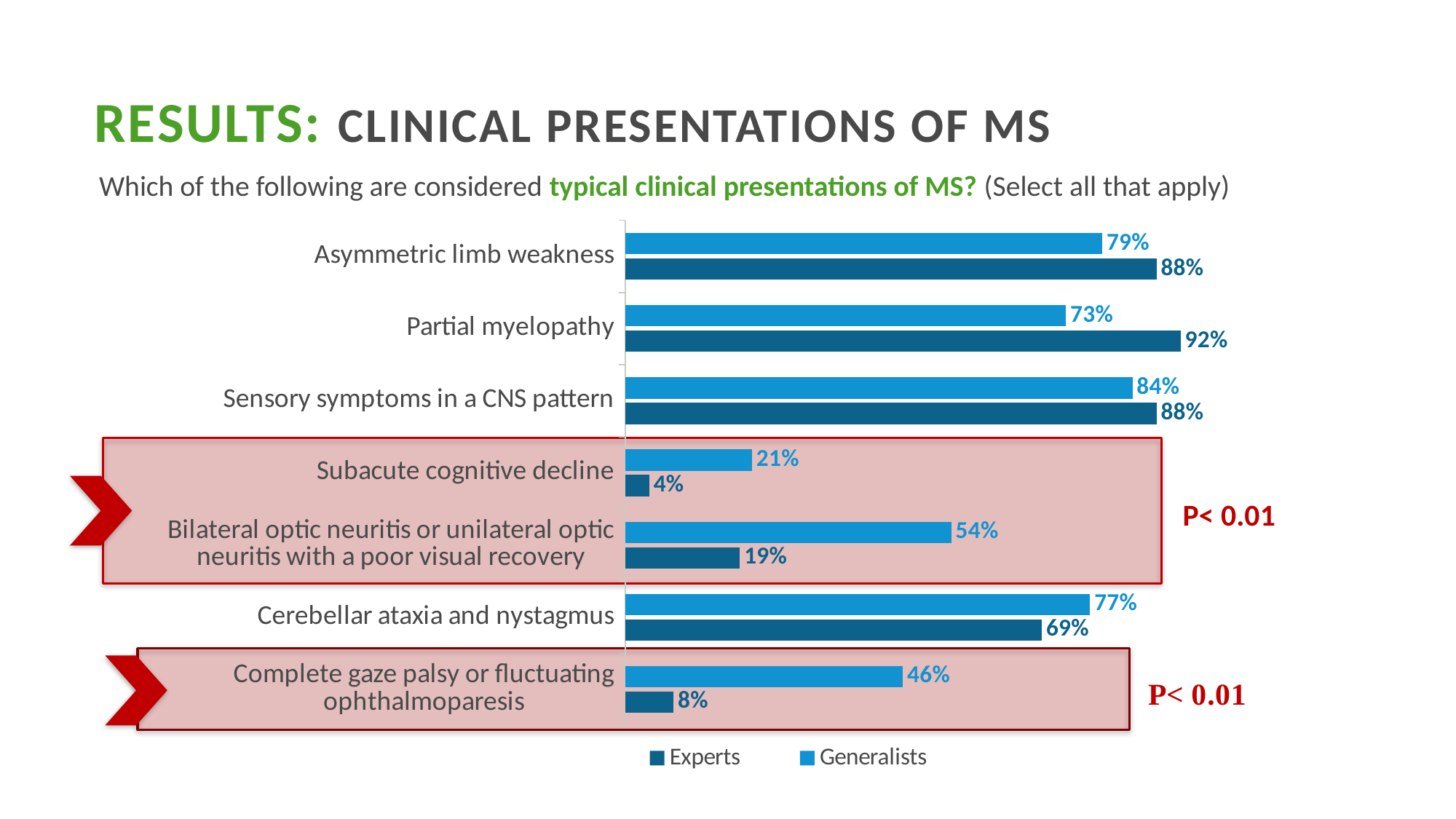
What percentage of Experts selected Partial myelopathy as a typical clinical presentation of MS? 92% For Asymmetric limb weakness, which group has the larger value, Experts or Generalists? Experts For Cerebellar ataxia and nystagmus, which group has the larger value, Experts or Generalists? Generalists Which category has the highest value for Experts? Partial myelopathy What is the difference between the Generalists and Experts values for Bilateral optic neuritis or unilateral optic neuritis with a poor visual recovery? 35% Which series is shown in the darker blue colour? Experts How many series does the legend list? 2 What type of chart is shown on the slide? Bar chart Which category has the lowest value for Generalists? Subacute cognitive decline What percentage of Experts selected Complete gaze palsy or fluctuating ophthalmoparesis? 8% What percentage of Generalists selected Subacute cognitive decline? 21% How many clinical presentation categories are shown in the chart? 7